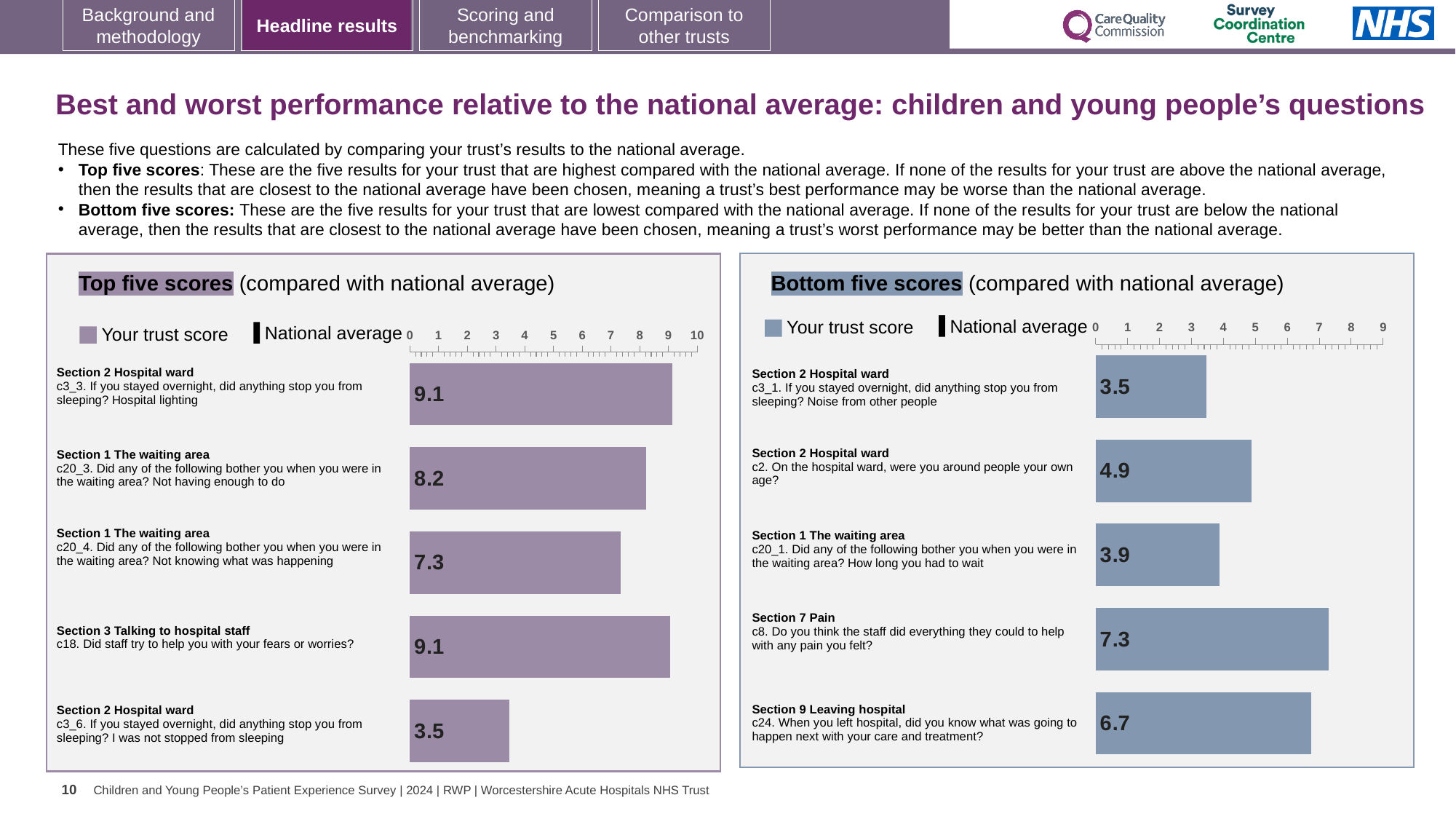
In the Bottom five scores chart, what is the trust score for c2 (were you around people your own age)? 4.9 How many questions are shown in the Top five scores chart? 5 In the Top five scores chart, what is the difference between the trust scores for c20_3 and c20_4? 0.9 In the Bottom five scores chart, which question has the highest trust score? c8. Do you think the staff did everything they could to help with any pain you felt? In the Bottom five scores chart, which has the larger trust score: c2 or c20_1? c2 In the Top five scores chart, which question has the lowest trust score? c3_6. I was not stopped from sleeping In the Bottom five scores chart, what is the difference between the trust scores for c8 and c24? 0.6 In the Top five scores chart, what is the trust score for c3_3 (hospital lighting stopping you from sleeping)? 9.1 What kind of chart is the Bottom five scores chart? Bar chart In the Bottom five scores chart, which question has the lowest trust score? c3_1. Noise from other people In the Bottom five scores chart, what is the trust score for c24 (did you know what was going to happen next with your care and treatment)? 6.7 In the Top five scores chart, what is the trust score for c20_3 (not having enough to do in the waiting area)? 8.2